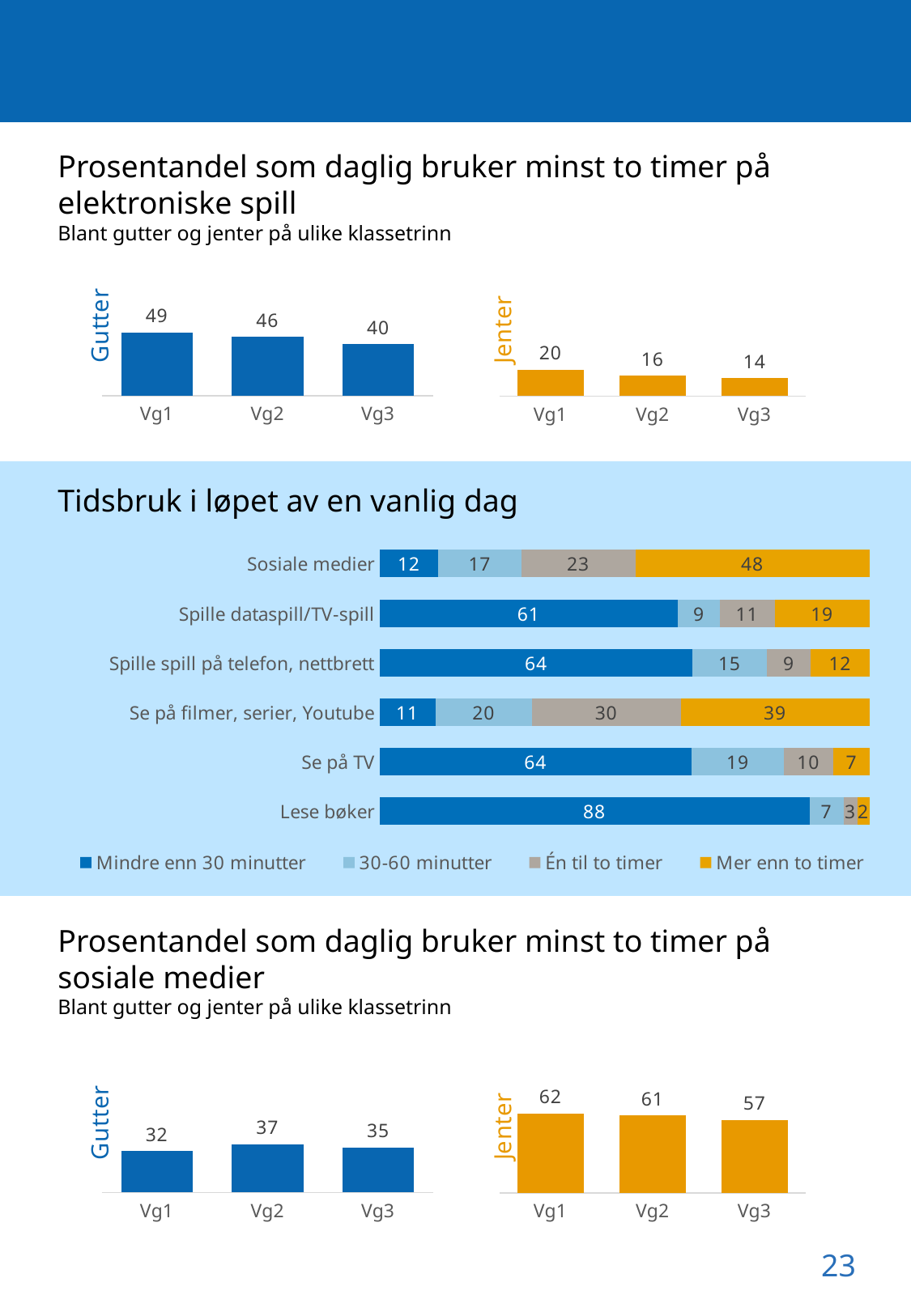
In the 'Prosentandel som daglig bruker minst to timer på elektroniske spill' chart for Jenter, which class level has the lowest value? Vg3 In the 'Prosentandel som daglig bruker minst to timer på elektroniske spill' chart for Gutter, do the values rise or fall from Vg1 to Vg3? fall In the 'Prosentandel som daglig bruker minst to timer på sosiale medier' chart for Gutter, which class level has the highest value? Vg2 In the 'Prosentandel som daglig bruker minst to timer på elektroniske spill' chart for Gutter, what is the value for Vg1? 49 In the 'Tidsbruk i løpet av en vanlig dag' chart, which is larger for 'Se på TV': '30-60 minutter' or 'Én til to timer'? 30-60 minutter What kind of chart is 'Tidsbruk i løpet av en vanlig dag'? stacked bar chart In the 'Tidsbruk i løpet av en vanlig dag' chart, what is the value for 'Mer enn to timer' for Sosiale medier? 48 In the 'Prosentandel som daglig bruker minst to timer på sosiale medier' chart for Jenter, what is the value for Vg1? 62 In the 'Tidsbruk i løpet av en vanlig dag' chart, which activity has the highest value for 'Mindre enn 30 minutter'? Lese bøker How many activities are shown in the 'Tidsbruk i løpet av en vanlig dag' chart? 6 In the 'Prosentandel som daglig bruker minst to timer på elektroniske spill' charts, what is the difference between Gutter and Jenter at Vg2? 30 How many series does the legend of the 'Tidsbruk i løpet av en vanlig dag' chart list? 4